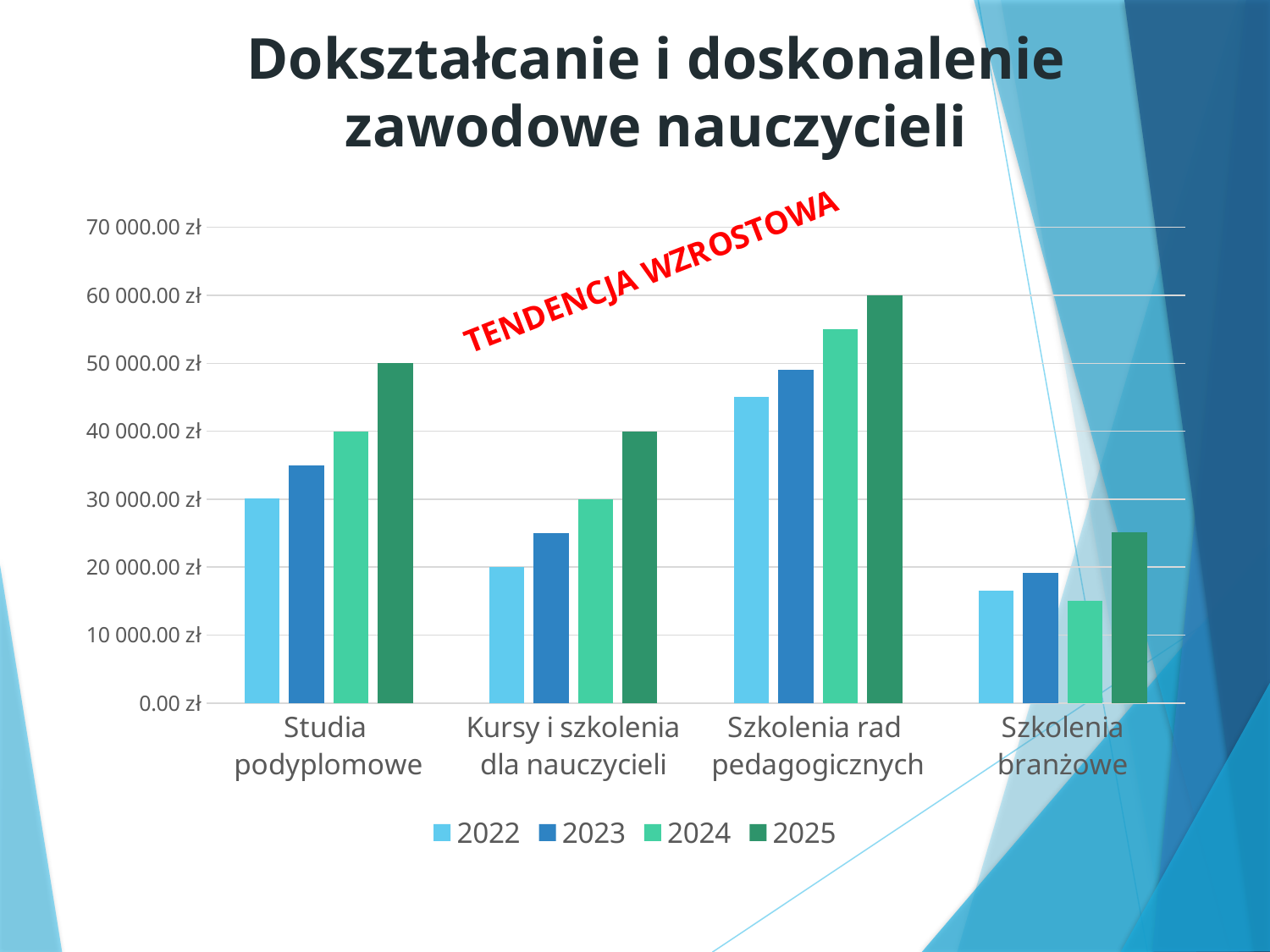
Which category has the lowest 2025 value? Szkolenia branżowe Which is larger: the 2025 value for Studia podyplomowe or the 2025 value for Kursy i szkolenia dla nauczycieli? Studia podyplomowe Is the 2023 value for Szkolenia branżowe greater or less than 20 000.00 zł? less What is the 2025 value for Studia podyplomowe? 50 000.00 zł What does the red annotation text on the chart say? TENDENCJA WZROSTOWA Do the values for Szkolenia rad pedagogicznych rise or fall from 2022 to 2025? rise Which category has the highest 2025 value? Szkolenia rad pedagogicznych Is the 2024 value for Szkolenia rad pedagogicznych greater or less than 50 000.00 zł? greater How many series does the legend list? 4 What is the 2025 value for Szkolenia rad pedagogicznych? 60 000.00 zł How many categories are shown on the x axis? 4 What kind of chart is shown on the slide? Bar chart